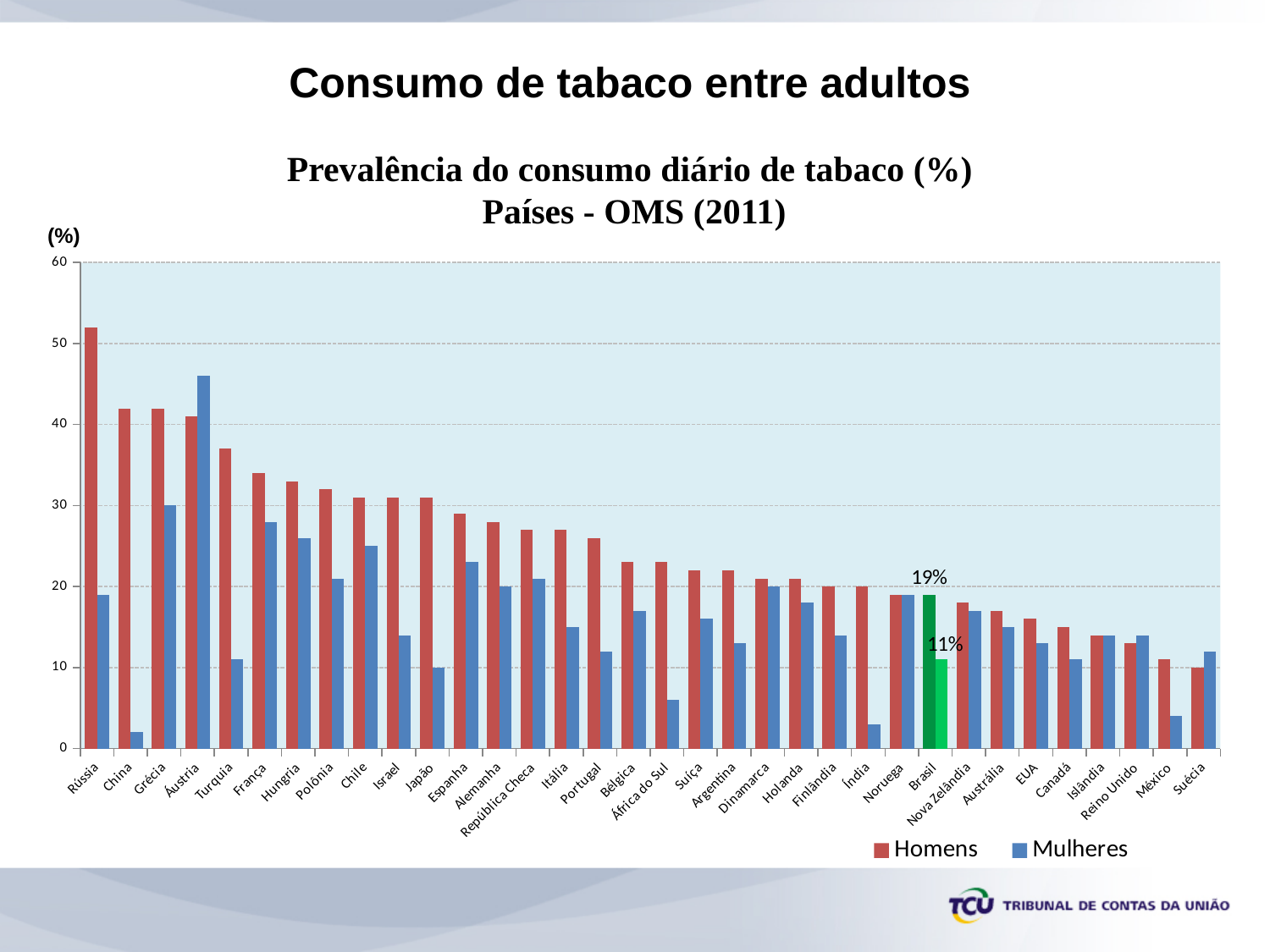
Which country has the highest Mulheres value? Áustria What is the Homens value for Brasil? 19% What are the two series named in the legend? Homens and Mulheres Is the Mulheres value for Índia greater or less than 10? less How many series does the legend list? 2 Which country has the lowest Mulheres value? China What is the Mulheres value for Brasil? 11% What is the difference between the Homens and Mulheres values for Brasil? 8 percentage points Do the Homens values generally rise or fall from left to right along the x axis? fall What type of chart is shown on the slide? Bar chart How many countries are shown on the x axis? 34 Which country has the highest Homens value? Rússia